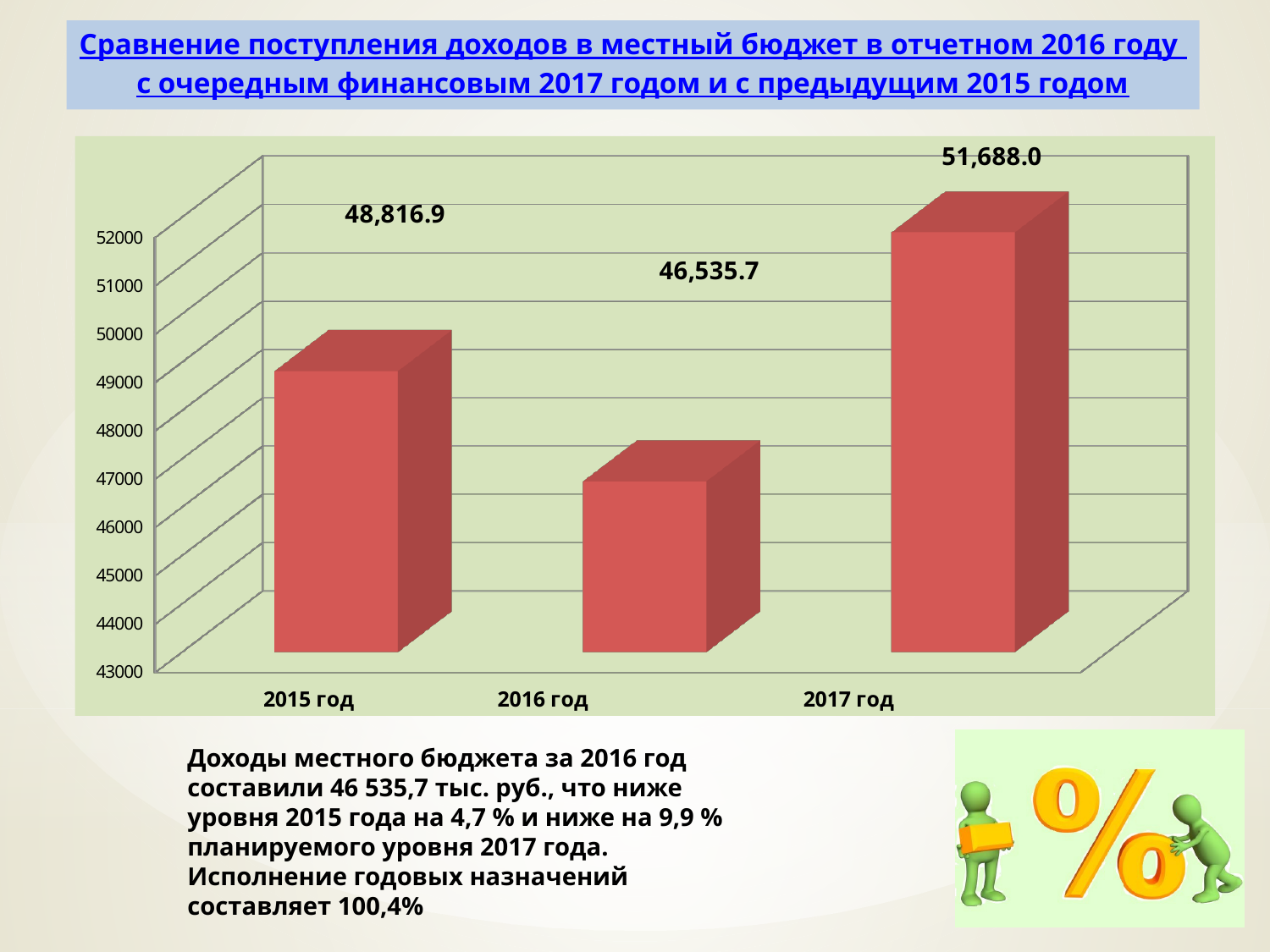
Is the value for 2016 год greater or less than 47000? less What is the value shown for 2016 год? 46,535.7 What is the difference between the values for 2015 год and 2016 год? 2,281.2 How many categories (years) are shown on the chart? 3 Which year has the highest value on the chart? 2017 год Which year has the lowest value on the chart? 2016 год What kind of chart is shown on the slide? bar chart Does the value rise or fall from 2015 год to 2016 год? fall What is the value shown for 2015 год? 48,816.9 What is the difference between the values for 2017 год and 2015 год? 2,871.1 Which is larger, the value for 2015 год or the value for 2016 год? 2015 год What is the value shown for 2017 год? 51,688.0